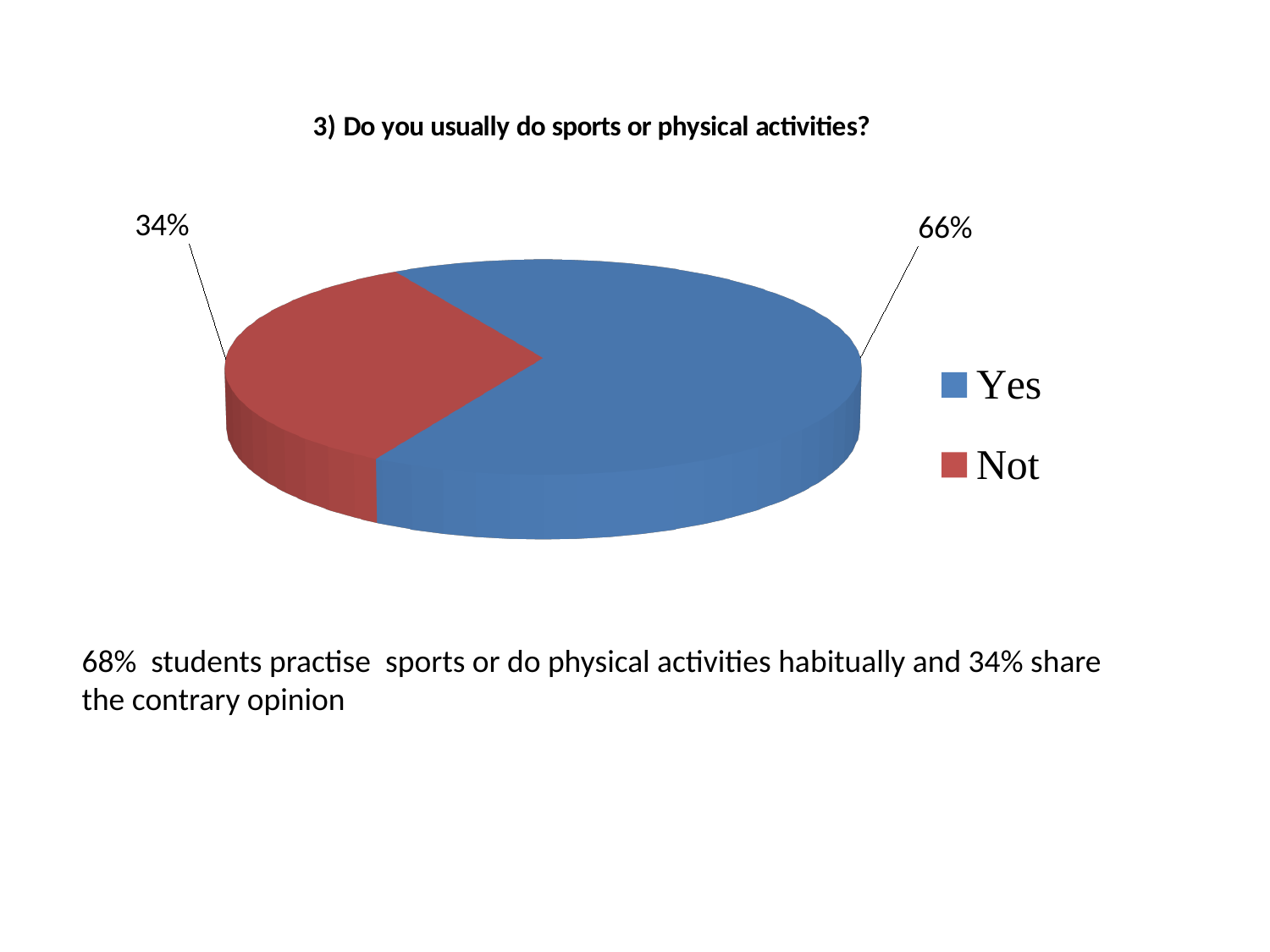
Which slice is the smallest? Not Which slice is the largest? Yes How many entries does the legend list? 2 What type of chart is shown on the slide? pie chart Which is larger, the Yes slice or the Not slice? Yes What is the chart's title? 3) Do you usually do sports or physical activities? What percentage of the pie is labelled for the Yes slice? 66% What share of the pie does the Yes slice represent? 66% How many slices does the pie chart have? 2 What is the difference in percentage points between the Yes and Not slices? 32 What percentage of the pie is labelled for the Not slice? 34% What colour is the Not slice? red